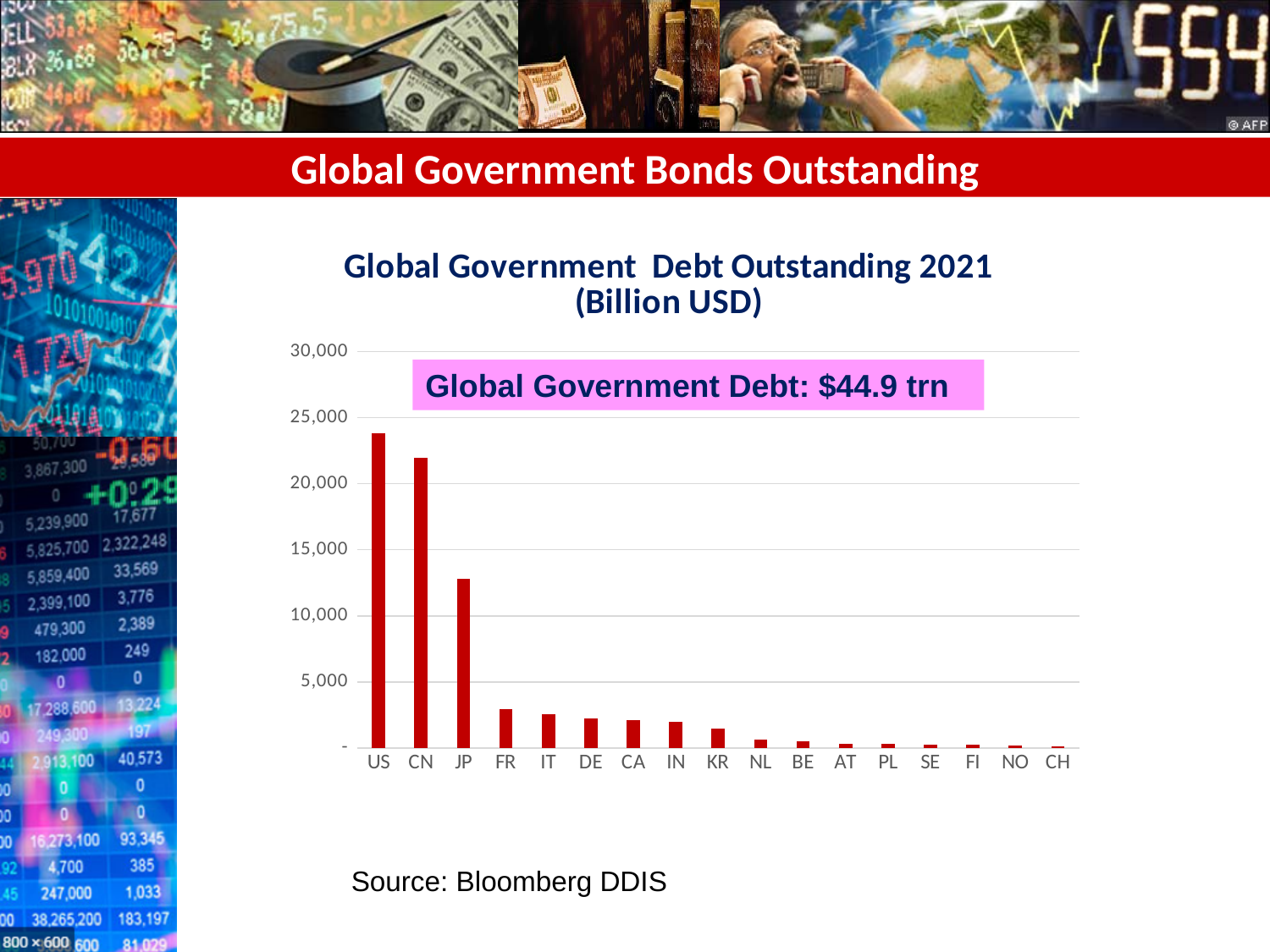
Is the value for JP greater or less than 15,000? less What is the title of the chart? Global Government Debt Outstanding 2021 (Billion USD) Do the bar values rise or fall moving from left to right along the x axis? fall Is the value for US greater or less than 20,000? greater Is the value for FR greater or less than 5,000? less What kind of chart is shown on the slide? bar chart Which country has the highest government debt outstanding in the chart? US Which is larger, the value for JP or the value for FR? JP What total global government debt figure is shown in the text box on the chart? $44.9 trn How many countries are shown on the x axis of the chart? 17